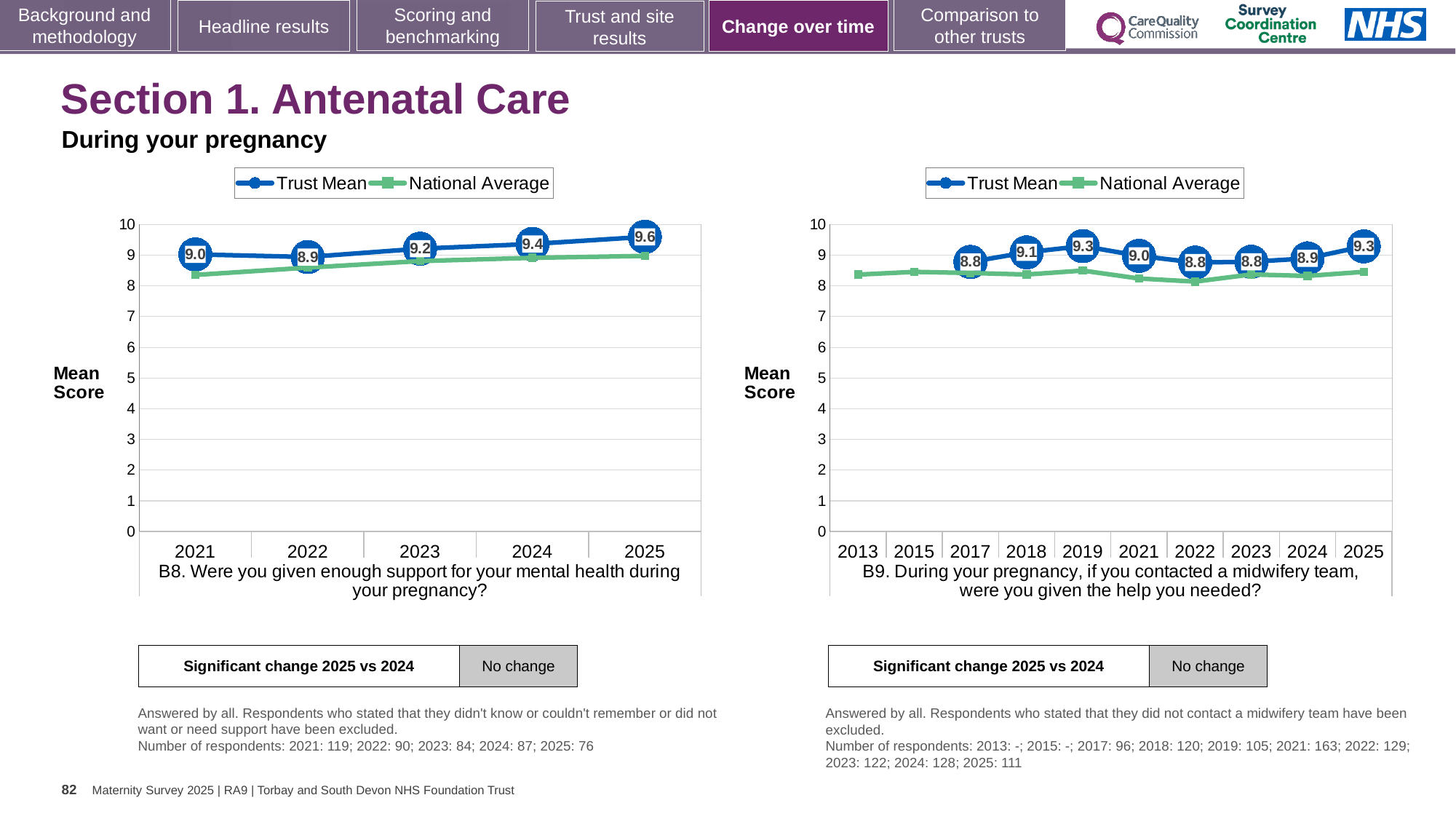
In the B8 chart (left), what is the Trust Mean for 2022? 8.9 In the B8 chart (left), does the Trust Mean generally rise or fall from 2021 to 2025? rise In the B9 chart (right), which year has the lowest Trust Mean among the labelled points? 2017, 2022 and 2023 (all 8.8) In the B9 chart (right), what is the Trust Mean for 2021? 9.0 In the B9 chart (right), is the National Average for 2025 greater or less than 9? less In the B8 chart (left), how many years are shown on the x axis? 5 In the B9 chart (right), is the Trust Mean for 2024 larger or smaller than the Trust Mean for 2025? smaller In the B8 chart (left), what is the Trust Mean for 2025? 9.6 In the B9 chart (right), what is the Trust Mean for 2019? 9.3 How many series does the legend of the B9 chart (right) list? 2 In the B8 chart (left), which year has the highest Trust Mean? 2025 In the B8 chart (left), what is the difference between the Trust Mean for 2025 and 2021? 0.6